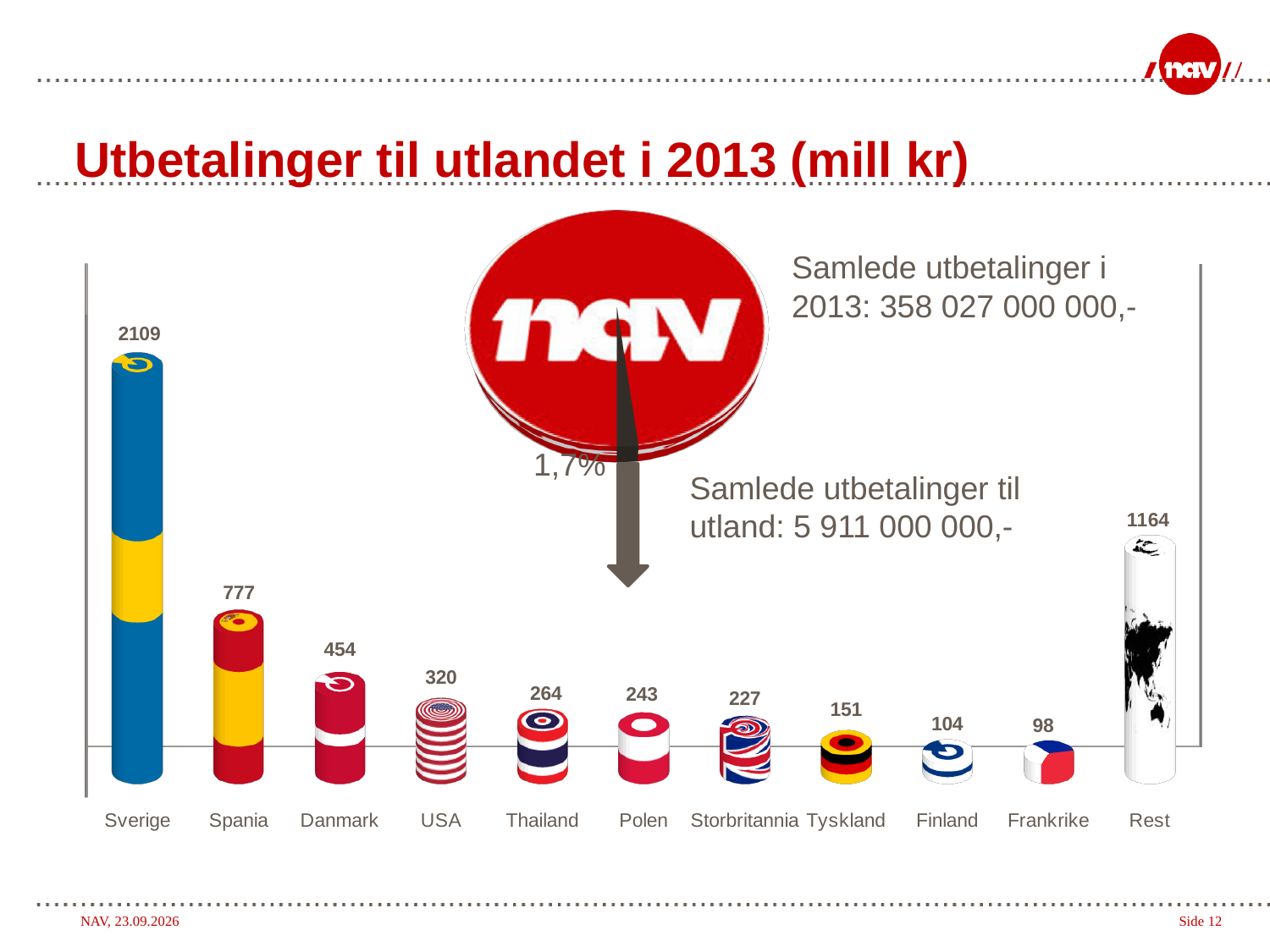
What is the value for Sverige? 2109 What is the difference between the values for Danmark and USA? 134 How many categories are shown on the x axis? 11 What is the title of the chart? Utbetalinger til utlandet i 2013 (mill kr) What is the difference between the values for Sverige and Spania? 1332 What is the value for Frankrike? 98 What is the value for Spania? 777 Which is larger, the value for Polen or the value for Storbritannia? Polen Which country has the highest value? Sverige Which category has the lowest value? Frankrike What kind of chart is shown on the slide? Bar chart What is the value for Thailand? 264